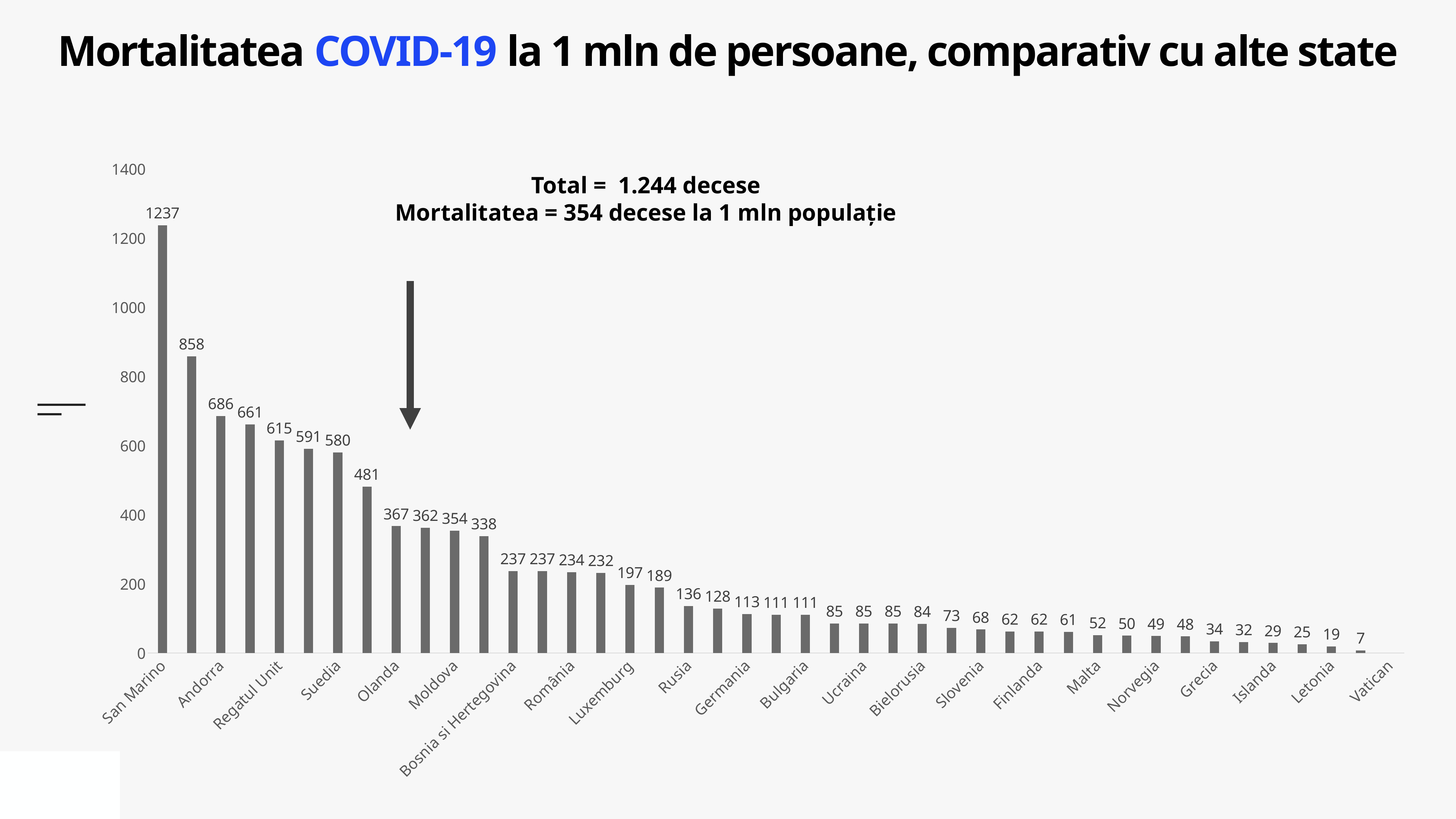
What is the value for Luxemburg? 197 What is the value for Suedia? 580 What kind of chart is shown? bar chart What is the difference between the values for San Marino and Andorra? 551 Do the values rise or fall from left to right along the x axis? fall What is the value for San Marino? 1237 Which country has the highest value? San Marino Is the value for Rusia greater or less than 200? less What is the value for Germania? 113 What is the value for Olanda? 367 Which is larger, the value for Regatul Unit or the value for Suedia? Regatul Unit What is the value for Moldova? 354